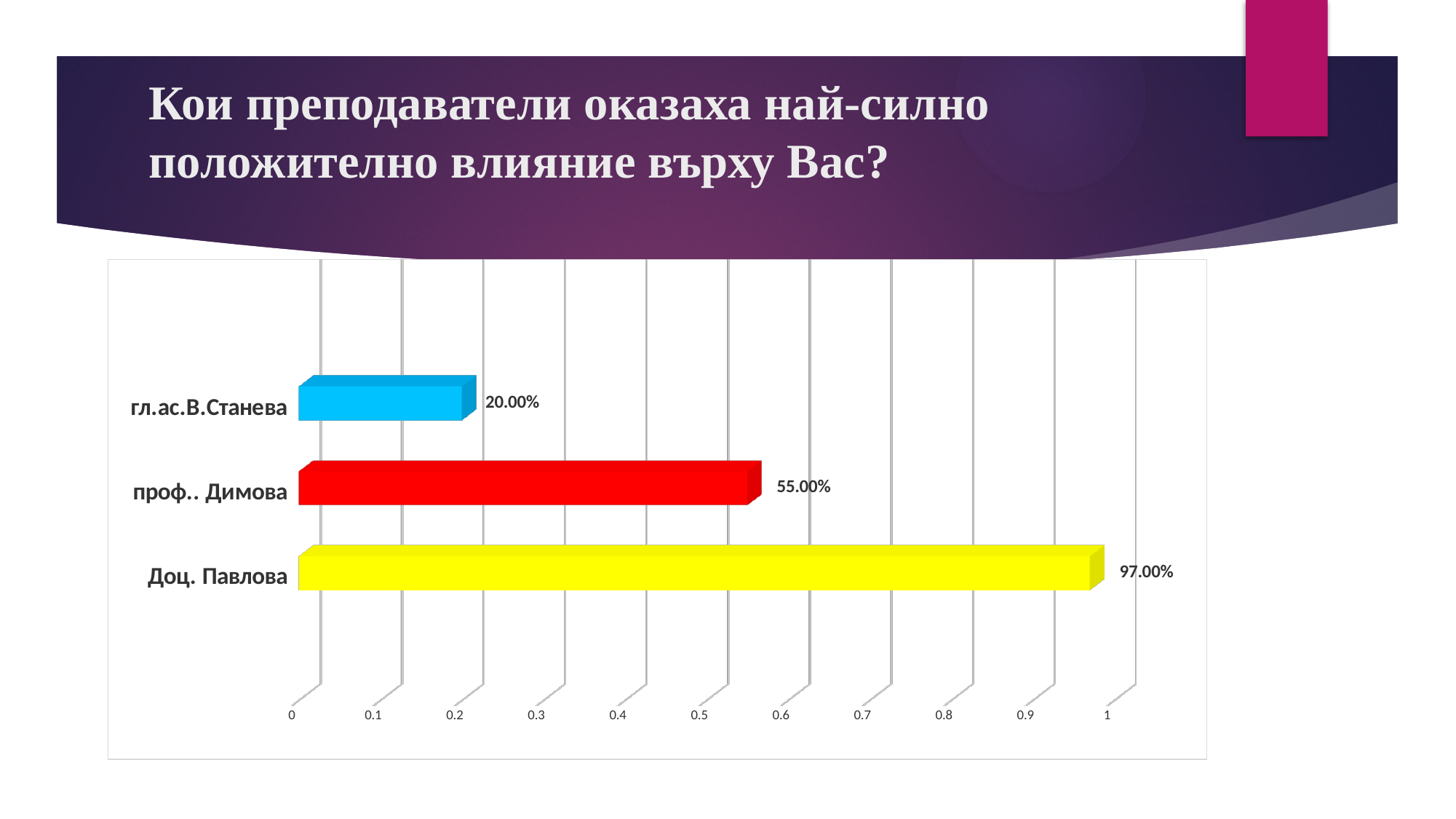
What is the difference between the values for Доц. Павлова and проф.. Димова? 42.00% What kind of chart is shown on the slide? bar chart Which is larger, the value for проф.. Димова or the value for гл.ас.В.Станева? проф.. Димова Which category has the highest value? Доц. Павлова How many categories are shown in the chart? 3 What is the value for Доц. Павлова? 97.00% Which category has the lowest value? гл.ас.В.Станева What is the difference between the values for проф.. Димова and гл.ас.В.Станева? 35.00% What is the value for проф.. Димова? 55.00% What is the value for гл.ас.В.Станева? 20.00% Is the value for проф.. Димова greater or less than 0.5 on the axis? greater What colour is the bar for Доц. Павлова? yellow